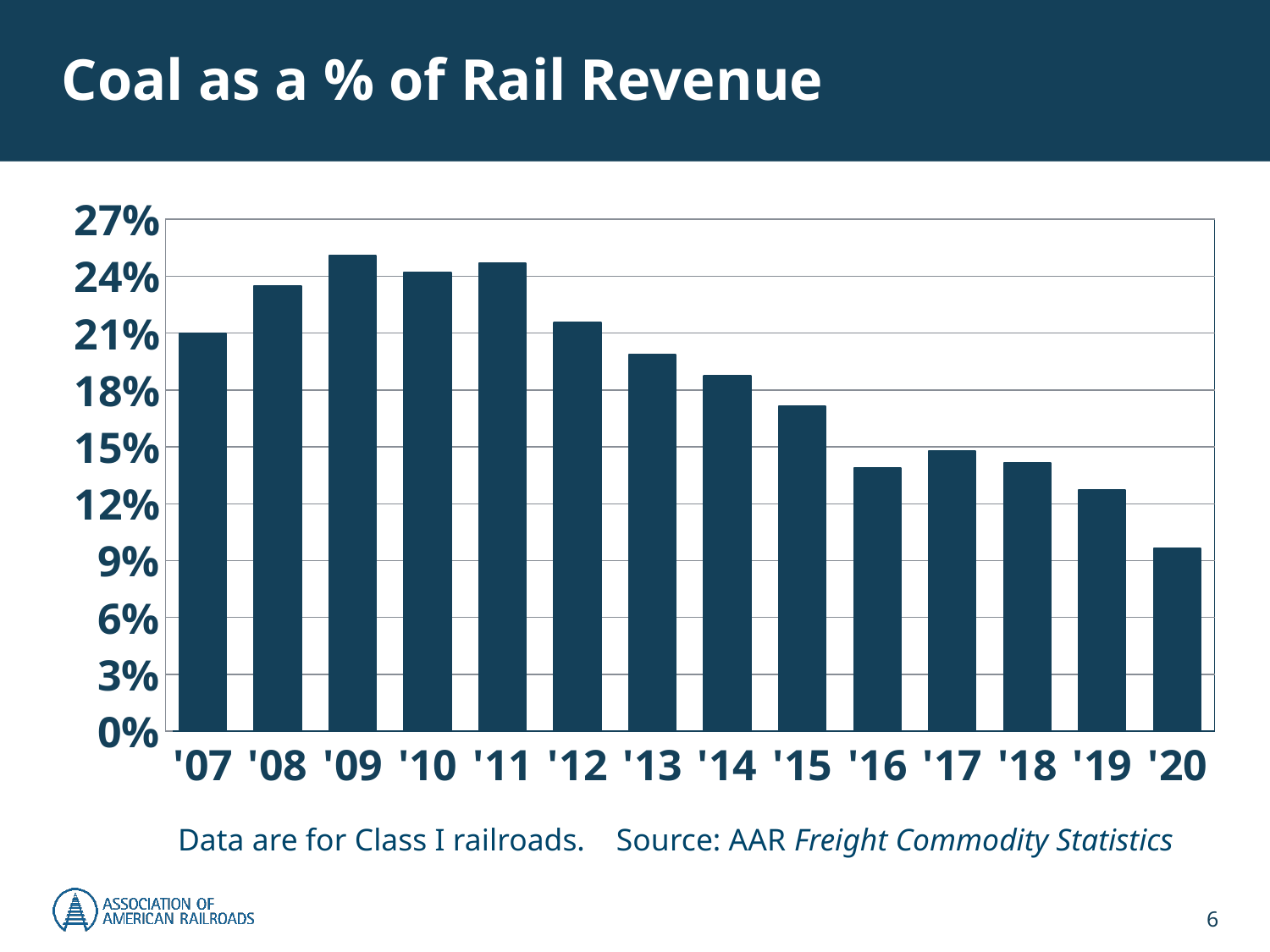
Which year has the lowest value in the chart? '20 Is the value for '16 greater or less than 15%? less Overall, do the values rise or fall from '11 to '20? fall Which is larger, the value for '08 or the value for '12? '08 What kind of chart is shown on the slide? bar chart What is the title of the chart? Coal as a % of Rail Revenue Is the value for '09 greater or less than 24%? greater Which is larger, the value for '14 or the value for '17? '14 Is the value for '13 greater or less than 21%? less How many years are shown on the x axis of the chart? 14